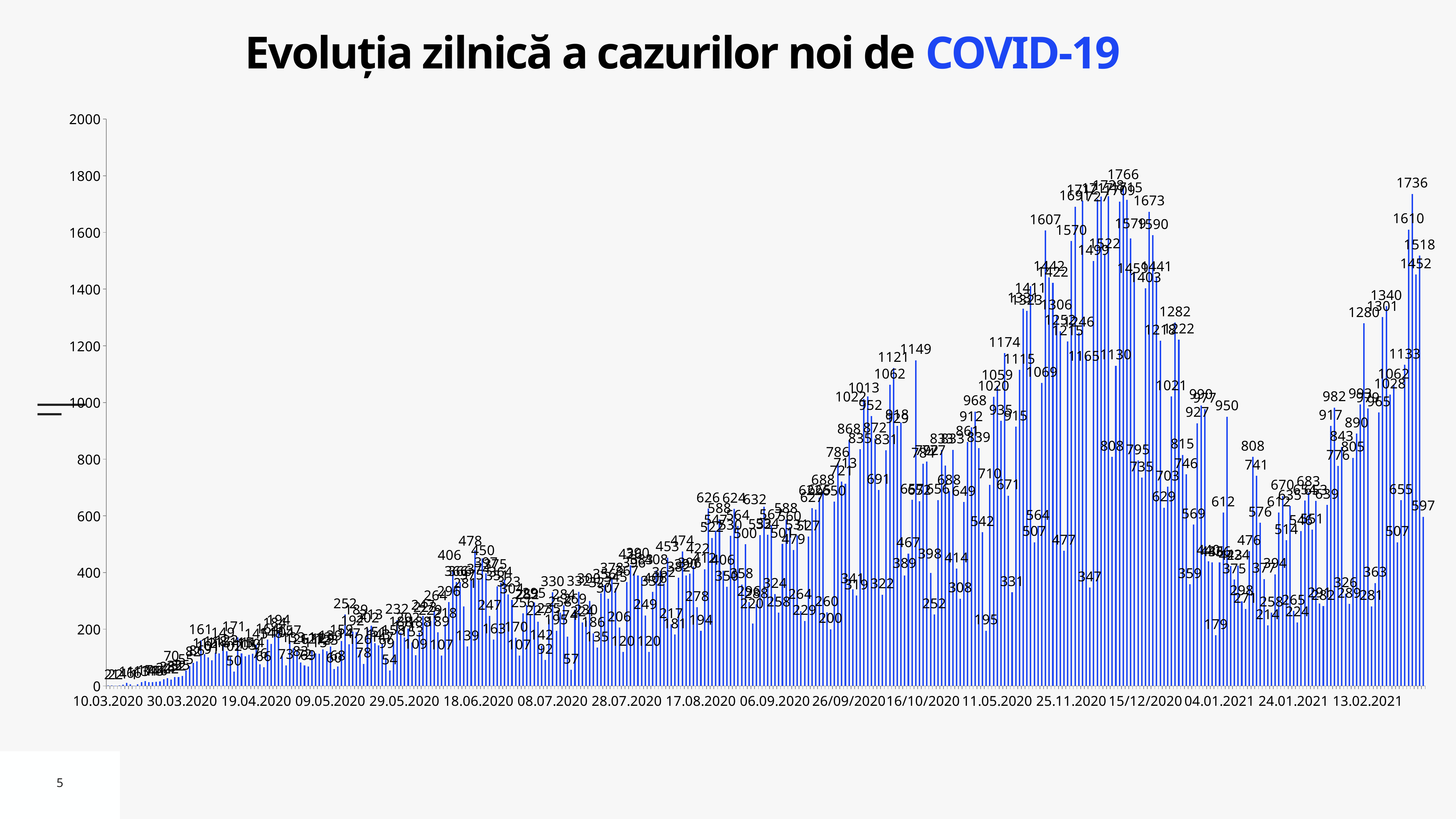
What is the value labelled on the last bar at the right end of the chart? 597 Is the value of the last bar on the chart (597) greater or less than 600? less What is the difference between the bars labelled 1610 and 1518 near the right end of the chart? 92 Which is larger, the bar labelled 1607 or the bar labelled 1673? 1673 What is the title of the chart? Evoluția zilnică a cazurilor noi de COVID-19 What is the highest daily value labelled on the chart? 1766 Overall, do the daily values rise or fall from March 2020 to February 2021? rise What is the value of the tallest bar in the February 2021 part of the chart? 1736 What is the difference between the overall peak value 1766 and the February 2021 peak value 1736? 30 What kind of chart is shown on the slide? bar chart What is the maximum value shown on the vertical axis? 2000 What is the value of the local peak in June 2020, labelled just above the 450 bar? 478